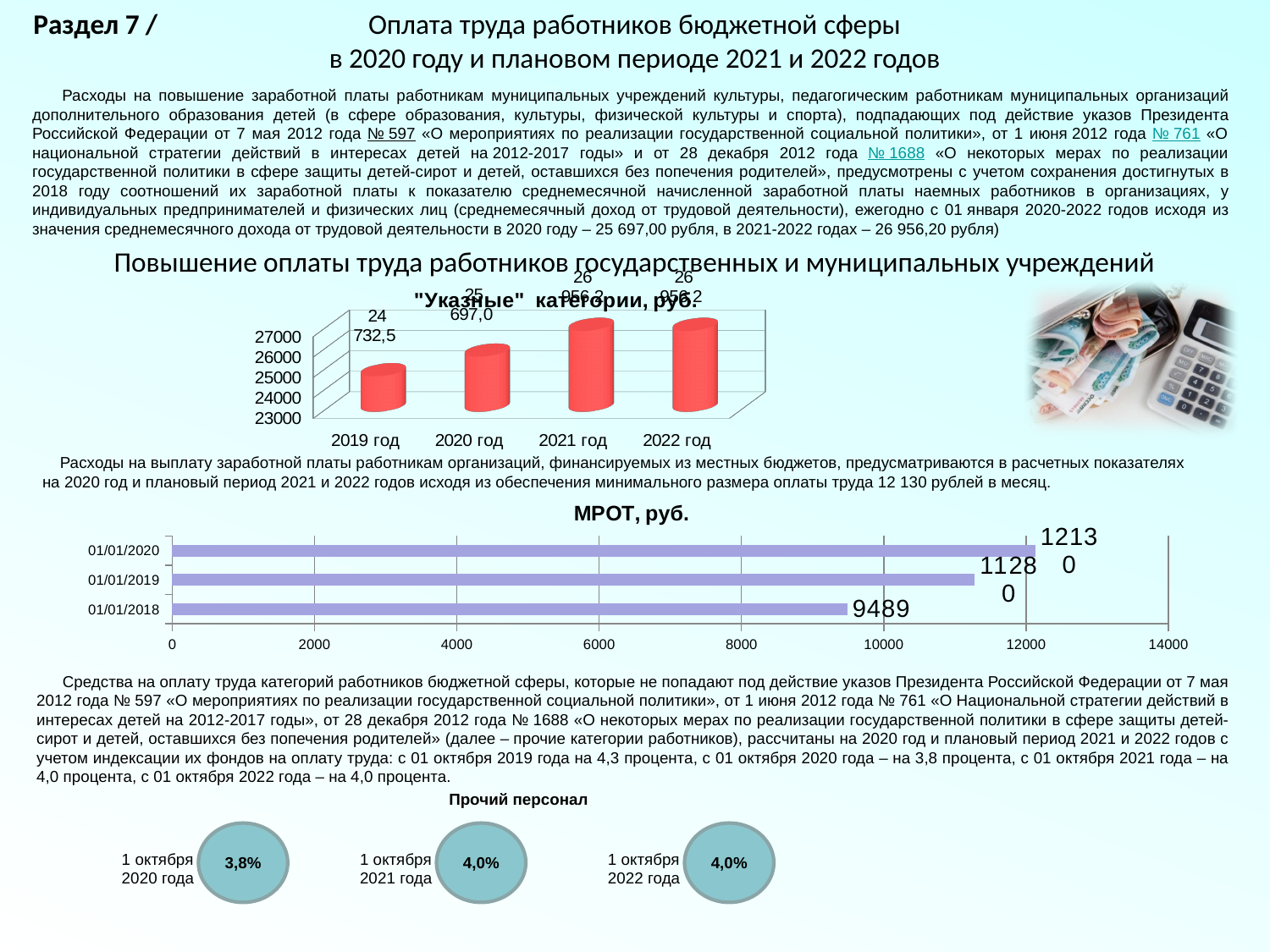
What kind of chart is the "МРОТ, руб." chart? Bar chart In the "Указные" категории, руб. chart, how many years are shown on the x axis? 4 In the "Указные" категории, руб. chart, is the value for 2019 год greater or less than 25000? less In the "МРОТ, руб." chart, what is the value for 01/01/2020? 12130 In the "Указные" категории, руб. chart, what is the value for 2020 год? 25 697,0 In the "Указные" категории, руб. chart, what is the value for 2019 год? 24 732,5 In the "МРОТ, руб." chart, how many bars are plotted? 3 In the "МРОТ, руб." chart, what is the value for 01/01/2018? 9489 In the "МРОТ, руб." chart, what is the difference between the values for 01/01/2020 and 01/01/2018? 2641 In the "МРОТ, руб." chart, which date has the lowest value? 01/01/2018 In the "МРОТ, руб." chart, what is the value for 01/01/2019? 11280 In the "МРОТ, руб." chart, which date has the highest value? 01/01/2020